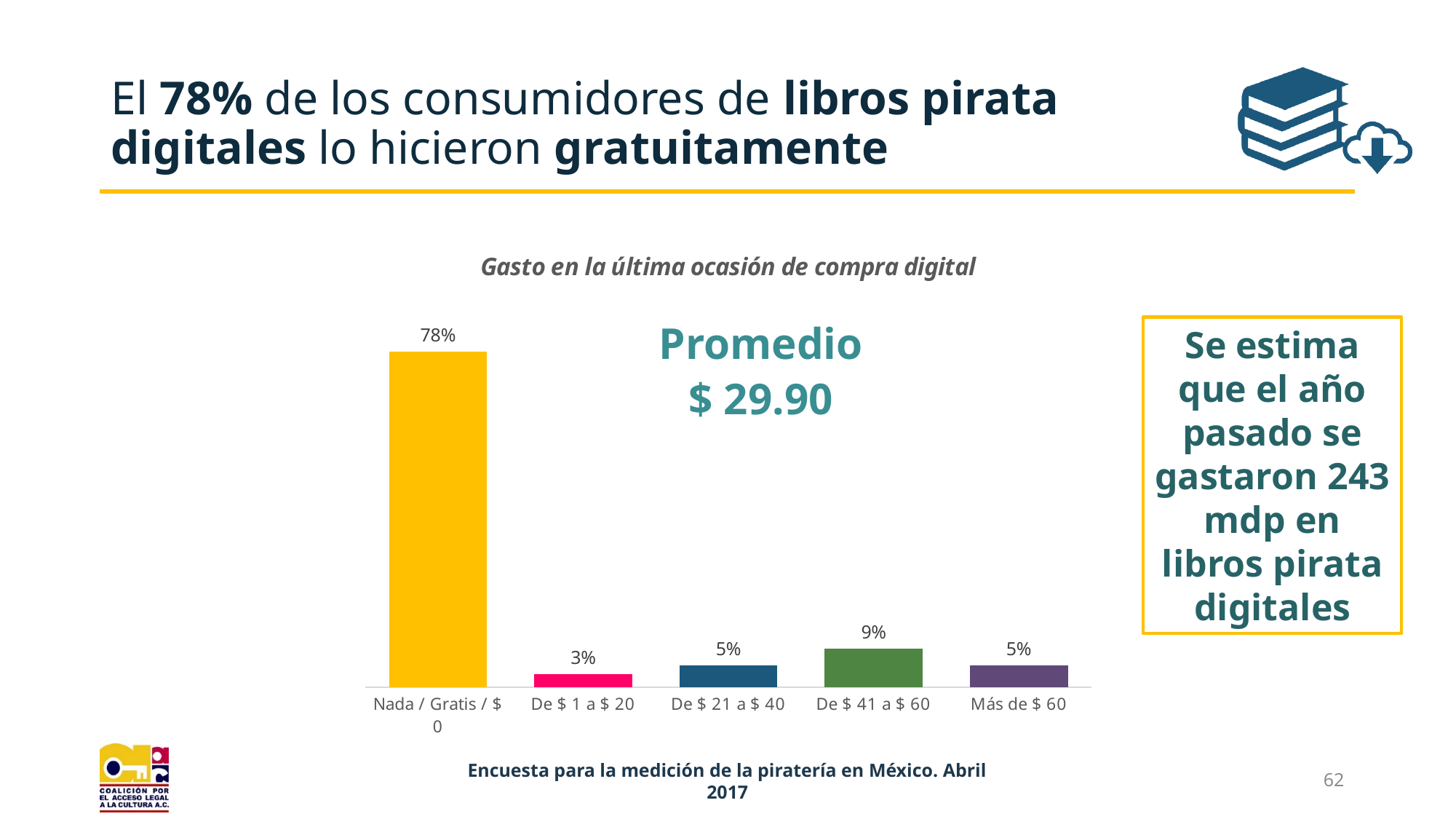
What is the value for the 'De $ 41 a $ 60' category? 9% What is the value for the 'Más de $ 60' category? 5% What is the difference between the values for 'Nada / Gratis / $ 0' and 'De $ 41 a $ 60'? 69% How many categories are shown on the x axis of the chart? 5 Which is larger, the value for 'De $ 41 a $ 60' or the value for 'De $ 21 a $ 40'? De $ 41 a $ 60 What is the value for the 'De $ 1 a $ 20' category? 3% What is the title of the chart? Gasto en la última ocasión de compra digital What is the value for the 'Nada / Gratis / $ 0' category? 78% What average (Promedio) value is displayed next to the chart? $ 29.90 What kind of chart is shown on the slide? Bar chart Which category has the lowest value? De $ 1 a $ 20 Which category has the highest value? Nada / Gratis / $ 0